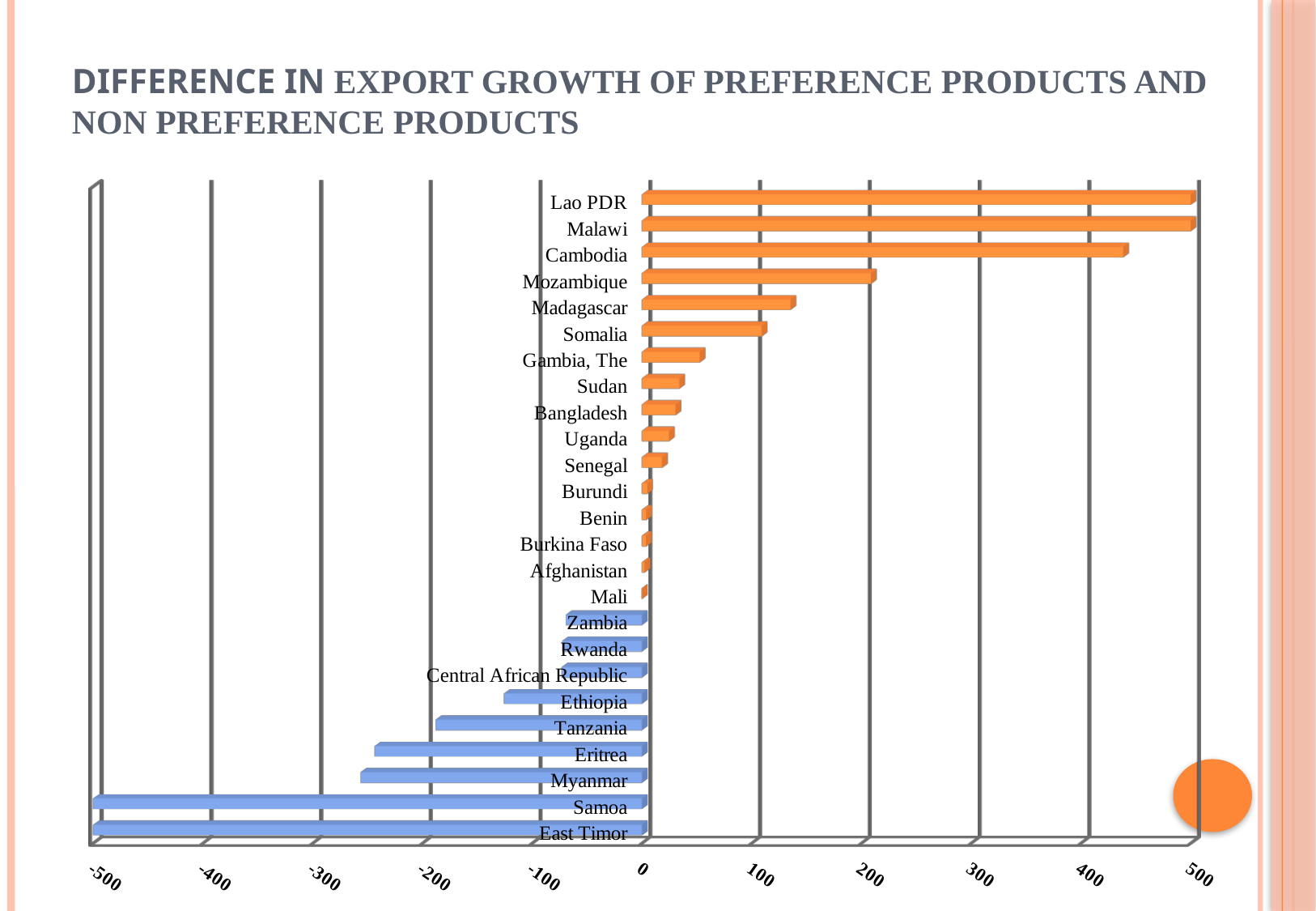
Is the value for Eritrea greater or less than -200? less Which has the larger value, Tanzania or Eritrea? Tanzania Which has the larger value, Cambodia or Mozambique? Cambodia How many countries are plotted in the chart? 25 What colour are the bars for countries with negative values? blue Is the value for Mozambique greater or less than 100? greater Is the value for Gambia, The greater or less than 100? less What kind of chart is shown on the slide? bar chart Which has the larger value, Madagascar or Somalia? Madagascar